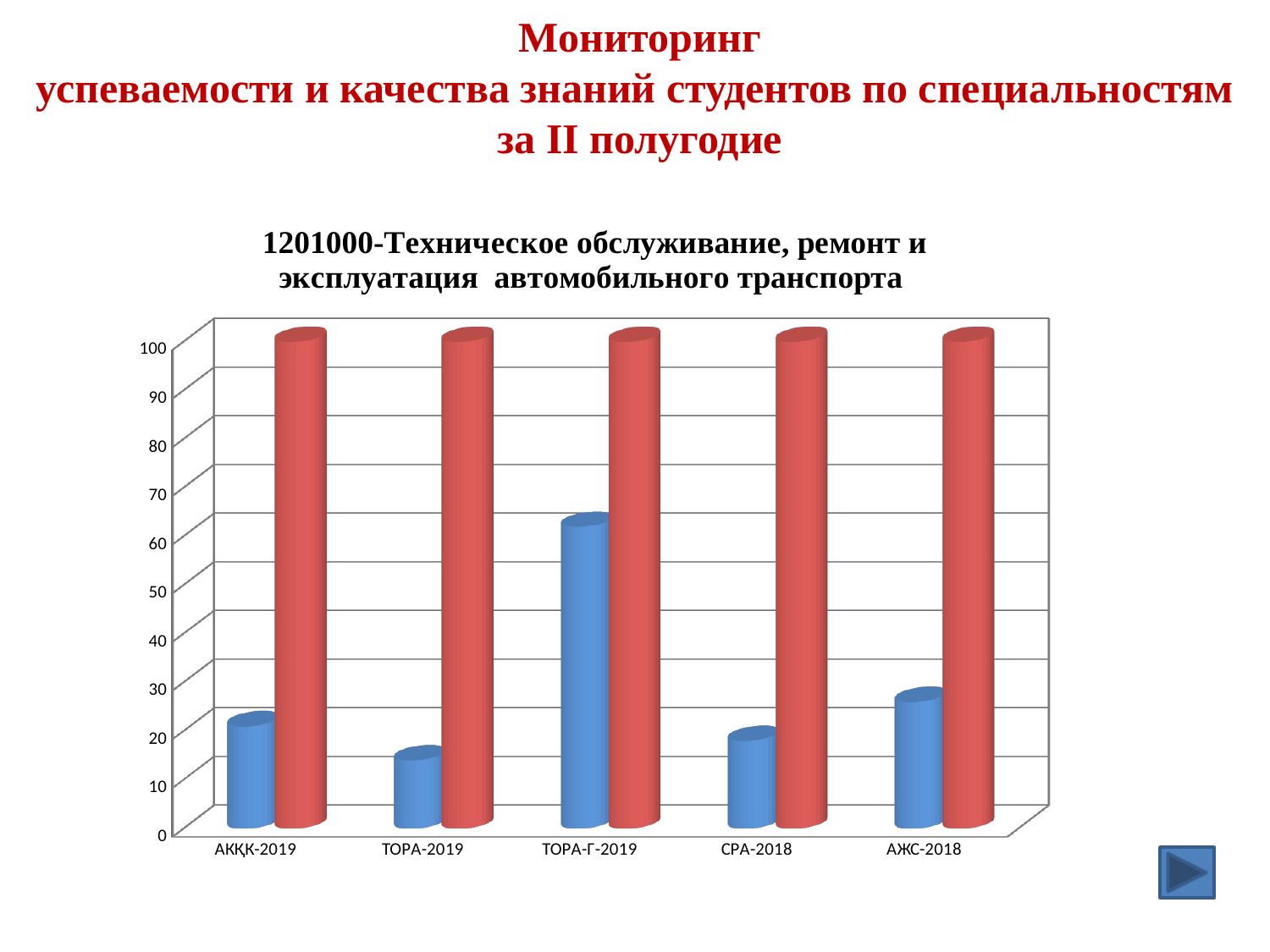
Which category has the highest blue bar? ТОРА-Г-2019 Is the blue bar for АЖС-2018 greater or less than 20? greater What kind of chart is shown on the slide? bar chart Which category has the lowest blue bar? ТОРА-2019 Is the blue bar for ТОРА-2019 greater or less than 20? less Which is larger, the blue bar for ТОРА-Г-2019 or the blue bar for СРА-2018? ТОРА-Г-2019 How many categories are shown on the x axis of the chart? 5 What value do the red bars reach for every category? 100 Is the blue bar for ТОРА-Г-2019 greater or less than 50? greater How many bars are plotted for each category in the chart? 2 What is the title of the chart? 1201000-Техническое обслуживание, ремонт и эксплуатация автомобильного транспорта